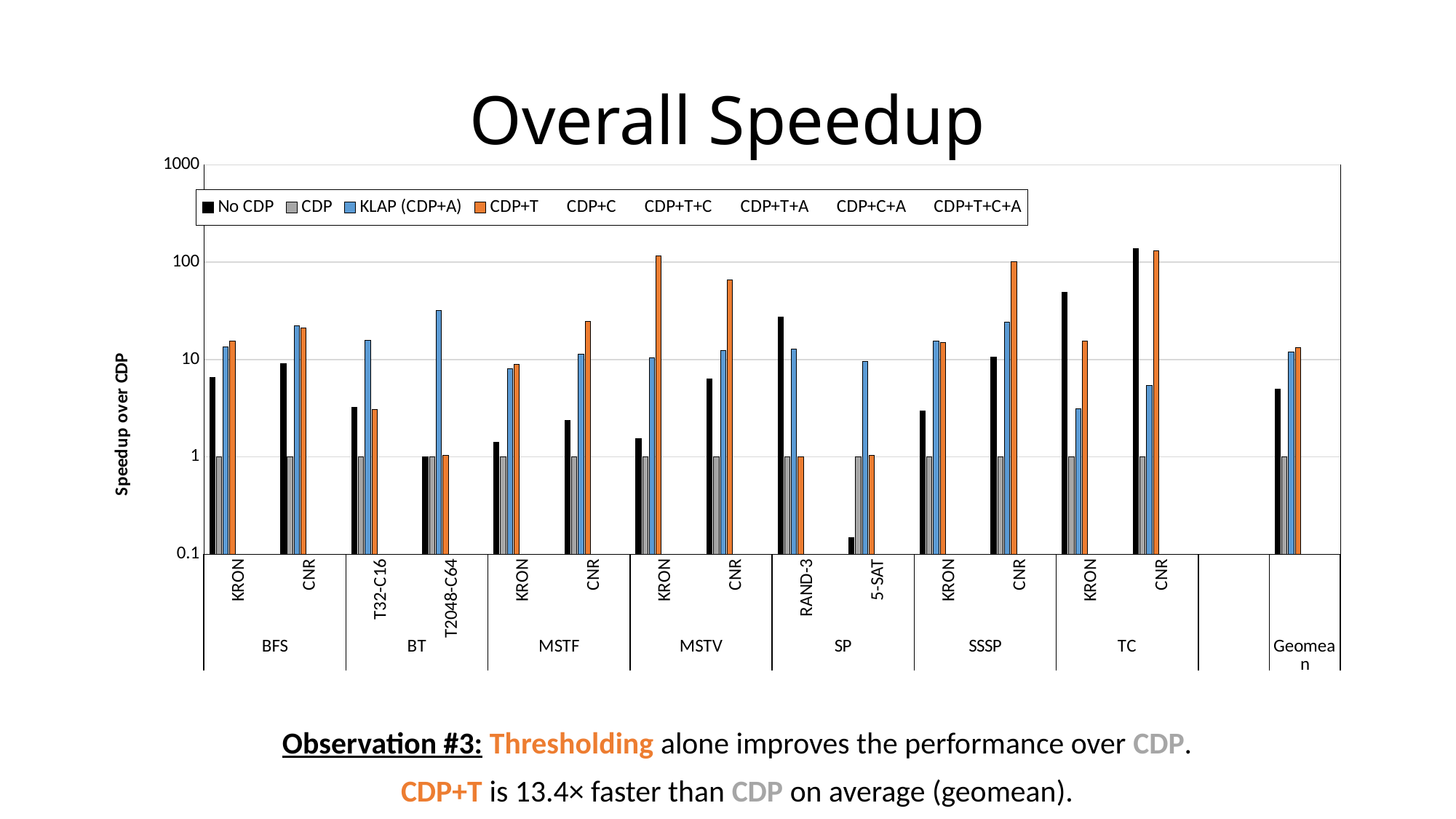
What is the value of the CDP bar for every input? 1 For SP RAND-3, which is larger: No CDP or KLAP (CDP+A)? No CDP What is the title of the chart? Overall Speedup What kind of chart is shown on the slide? bar chart What is the Geomean speedup of CDP+T over CDP? 13.4× Is the No CDP value for SP 5-SAT greater or less than 1? less Is the CDP+T value for MSTV KRON greater or less than 100? greater How many benchmark groups are shown on the x axis, not counting Geomean? 7 For BT T2048-C64, which is larger: KLAP (CDP+A) or CDP+T? KLAP (CDP+A) Is the KLAP (CDP+A) value for BT T2048-C64 greater or less than 10? greater How many series are plotted as bars in the chart? 4 What is the label of the vertical axis? Speedup over CDP